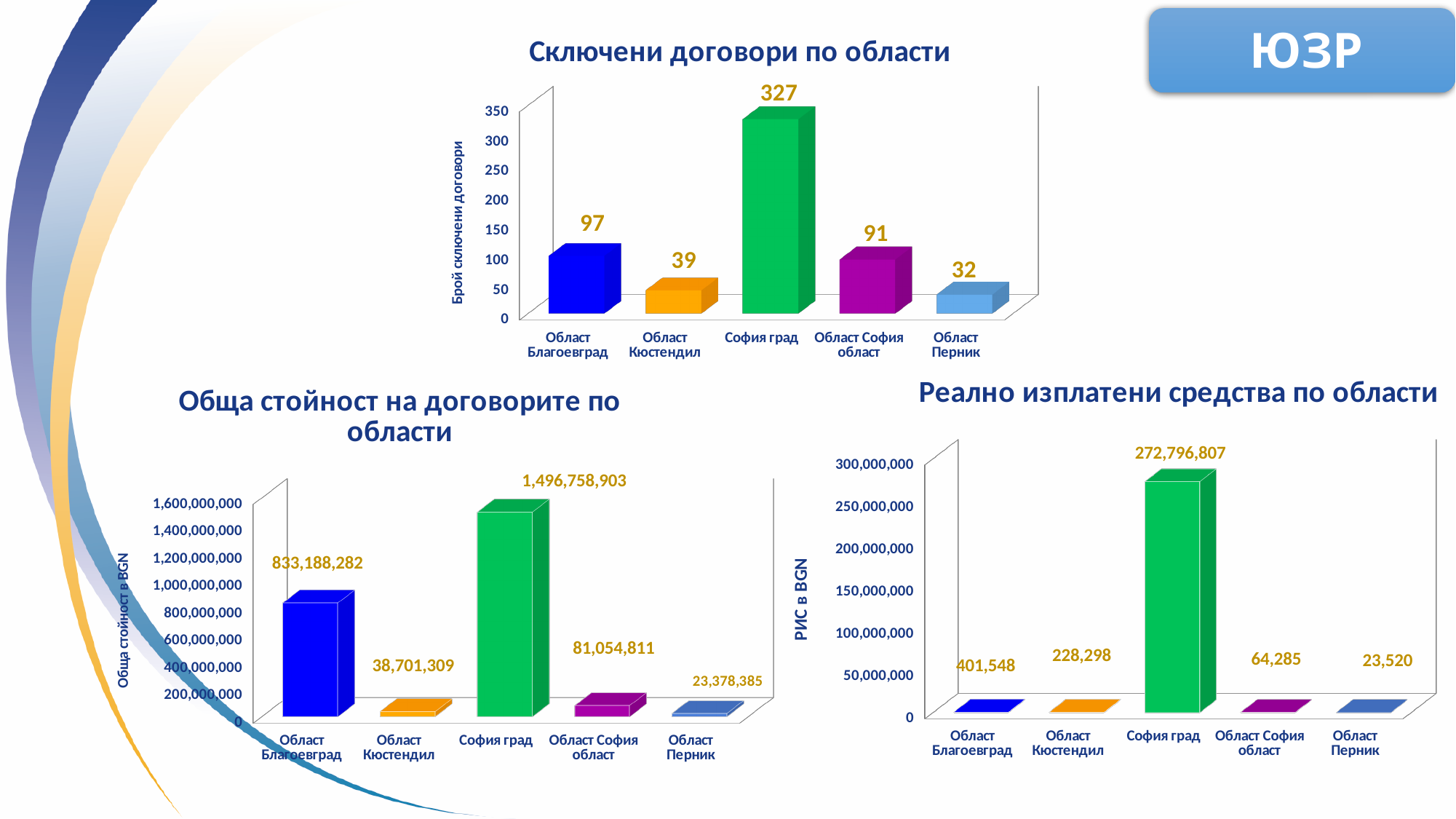
In the chart 'Реално изплатени средства по области', what is the difference between Област Благоевград and Област Кюстендил? 173,250 In the chart 'Реално изплатени средства по области', what is the value for София град? 272,796,807 In the chart 'Обща стойност на договорите по области', what is the value for Област Перник? 23,378,385 In the chart 'Сключени договори по области', what is the difference between София град and Област Благоевград? 230 In the chart 'Сключени договори по области', which is larger: Област Благоевград or Област София област? Област Благоевград In the chart 'Обща стойност на договорите по области', which category has the highest value? София град In the chart 'Сключени договори по области', what is the value for Област Кюстендил? 39 In the chart 'Сключени договори по области', how many contracts were concluded for София град? 327 What type of chart is 'Реално изплатени средства по области'? Bar chart In the chart 'Сключени договори по области', which category has the lowest value? Област Перник In the chart 'Обща стойност на договорите по области', what is the value for Област Благоевград? 833,188,282 How many categories are shown in the chart 'Сключени договори по области'? 5